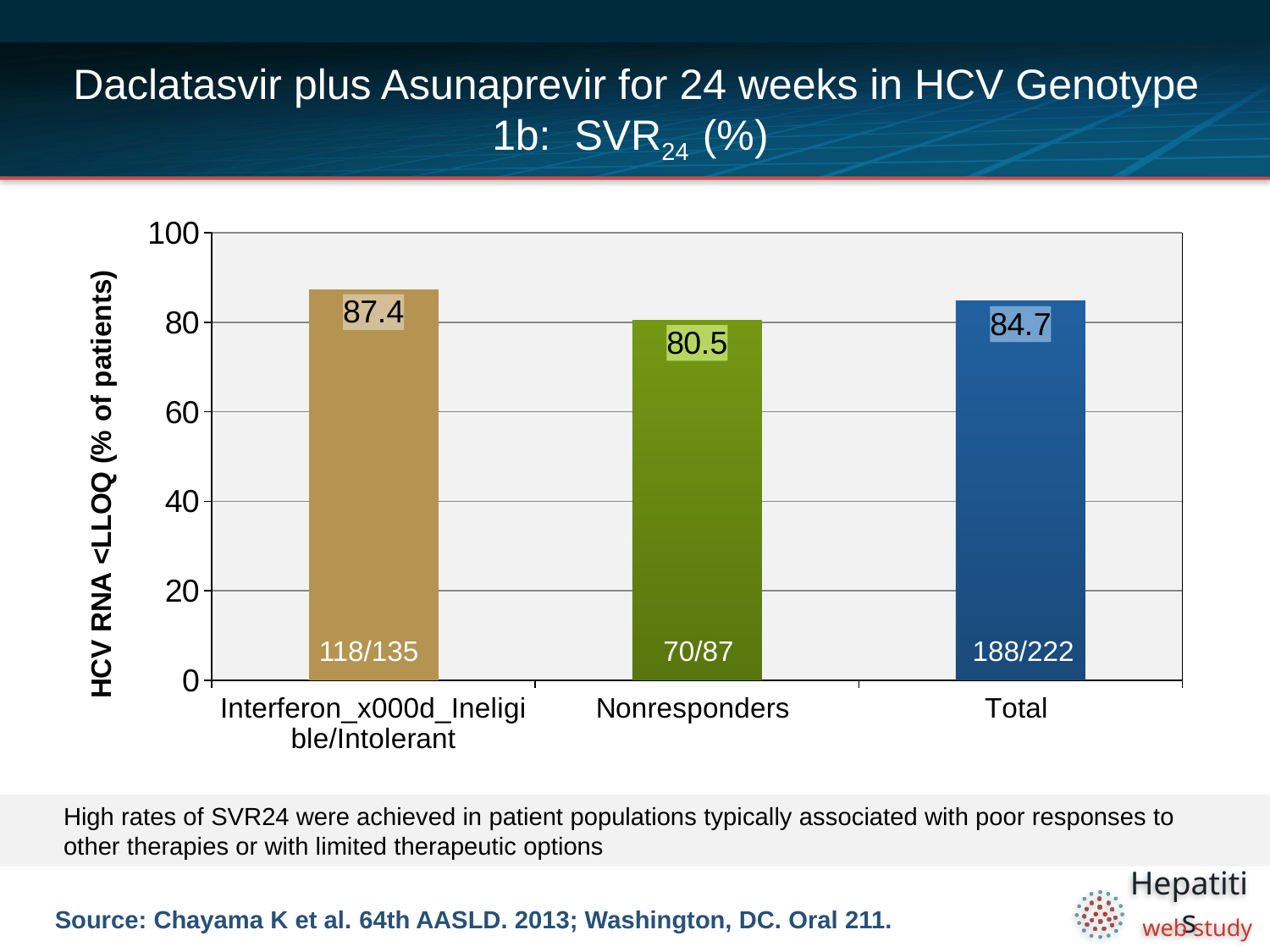
What is the SVR24 value for the Interferon Ineligible/Intolerant group? 87.4 What is the SVR24 value for the Total group? 84.7 What is the label of the y axis? HCV RNA <LLOQ (% of patients) Is the value for Nonresponders greater or less than 60? greater Which category has the highest SVR24 value? Interferon Ineligible/Intolerant What is the SVR24 value for Nonresponders? 80.5 What kind of chart is shown on the slide? bar chart Which is larger, the SVR24 value for Total or for Nonresponders? Total What fraction of patients is printed on the Total bar? 188/222 What is the difference between the SVR24 values for the Interferon Ineligible/Intolerant group and Nonresponders? 6.9 Which category has the lowest SVR24 value? Nonresponders How many categories are shown on the x axis? 3